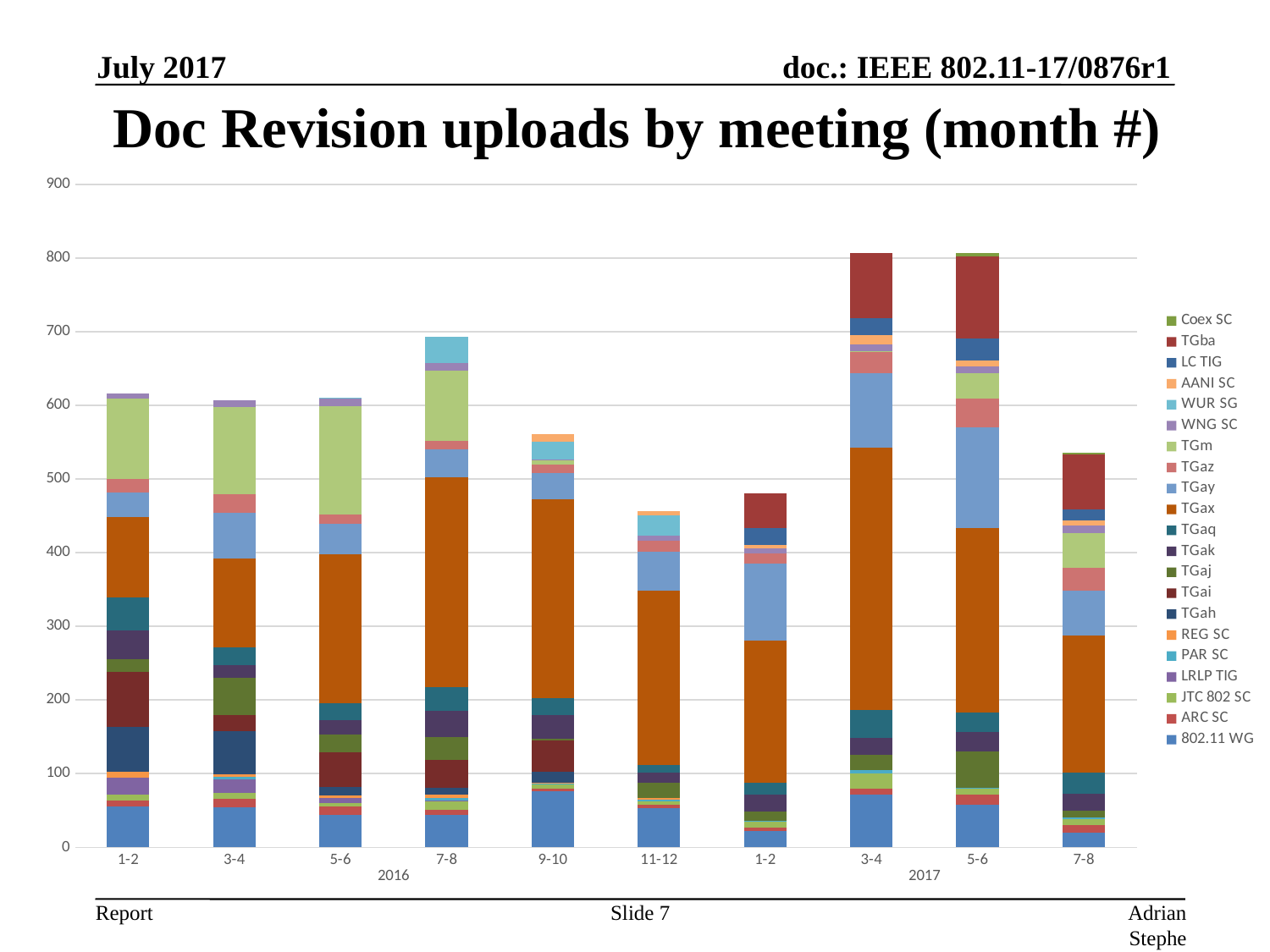
What is the title of the chart? Doc Revision uploads by meeting (month #) How many bars (meeting categories) are plotted on the x axis? 10 Which bar is taller, 2016 1-2 or 2016 11-12? 2016 1-2 How many series does the legend list? 21 Is the total for the 2017 1-2 bar greater or less than 500? less What kind of chart is shown on the slide? Stacked bar chart Is the total for the 2016 11-12 bar greater or less than 500? less Which bar is taller, 2017 5-6 or 2017 7-8? 2017 5-6 Is the total for the 2016 1-2 bar greater or less than 600? greater Which series is listed at the bottom of the legend? 802.11 WG